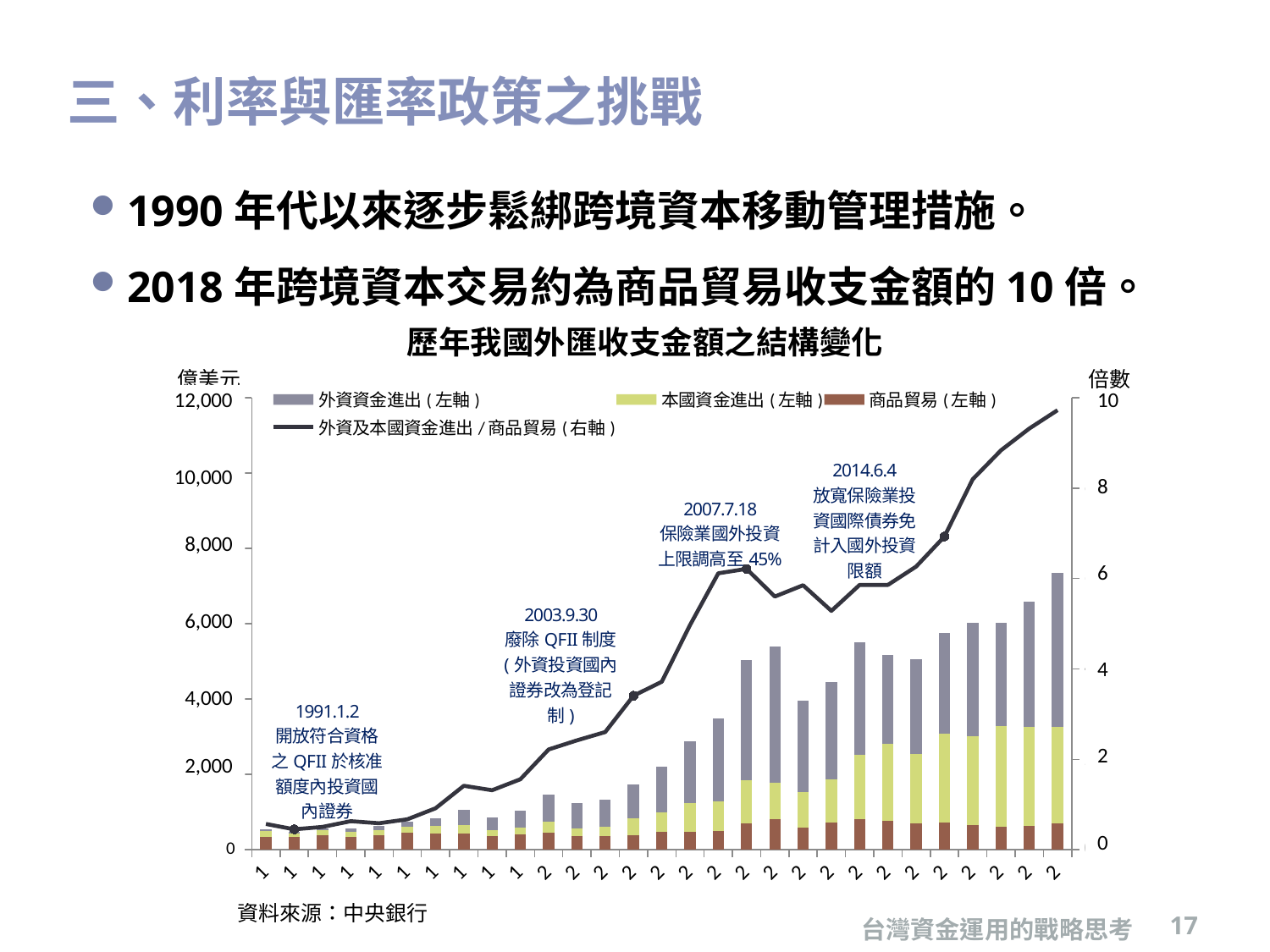
How many series does the chart's legend list? 4 Which is taller, the leftmost stacked bar or the rightmost stacked bar? The rightmost bar What is the title of the chart? 歷年我國外匯收支金額之結構變化 Is the value of the line at the rightmost point greater or less than 8 on the right axis? greater Does the line series (外資及本國資金進出 / 商品貿易) generally rise or fall from left to right? Rise Is the total of the leftmost stacked bar greater or less than 2,000? less Is the value of the line at the leftmost point greater or less than 2 on the right axis? less Which stacked bar is the tallest in the chart? The rightmost (last) bar What kind of chart is shown on the slide? A stacked bar chart combined with a line Which series is plotted on the right axis (右軸)? 外資及本國資金進出 / 商品貿易